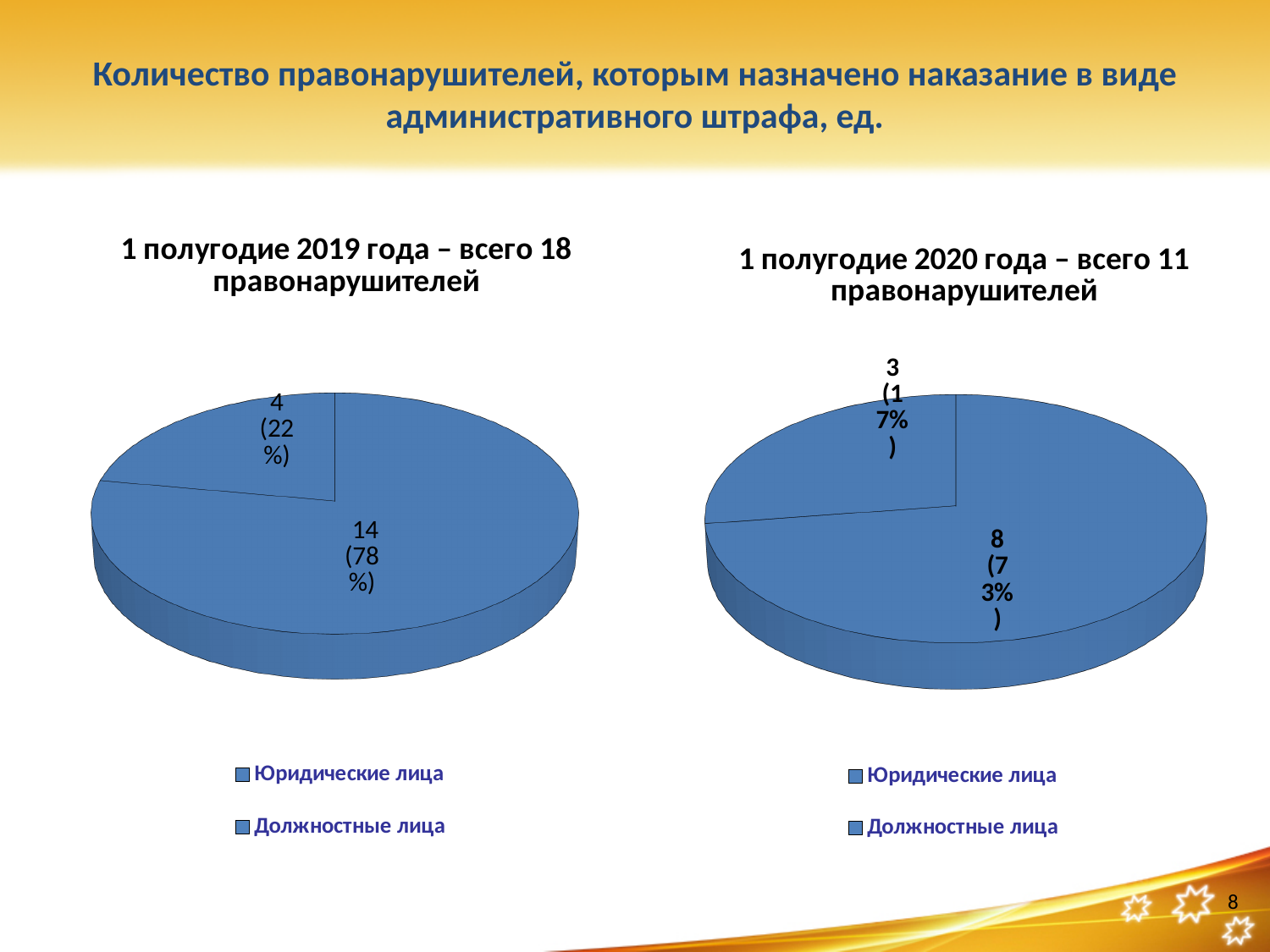
In the chart titled '1 полугодие 2019 года – всего 18 правонарушителей', what is the difference between the larger slice value (14) and the smaller slice value (4)? 10 In the chart titled '1 полугодие 2019 года – всего 18 правонарушителей', what share of the pie does the larger slice represent? 78% What kind of chart is used on this slide for the 1 полугодие 2019 года data? pie chart Which chart has the larger value for its biggest slice: the 1 полугодие 2019 года chart (14) or the 1 полугодие 2020 года chart (8)? 1 полугодие 2019 года In the chart titled '1 полугодие 2019 года – всего 18 правонарушителей', what is the data label on the larger slice? 14 (78%) How many entries does the legend of the left chart list? 2 How many slices does the chart titled '1 полугодие 2020 года – всего 11 правонарушителей' have? 2 In the chart titled '1 полугодие 2020 года – всего 11 правонарушителей', what share of the pie is shown for the smaller slice? 17% In the chart titled '1 полугодие 2020 года – всего 11 правонарушителей', what is the data label on the larger slice? 8 (73%) In the chart titled '1 полугодие 2020 года – всего 11 правонарушителей', what is the data label on the smaller slice? 3 (17%) In the chart titled '1 полугодие 2019 года – всего 18 правонарушителей', what is the data label on the smaller slice? 4 (22%) What are the two legend entries shown under the right chart? Юридические лица, Должностные лица